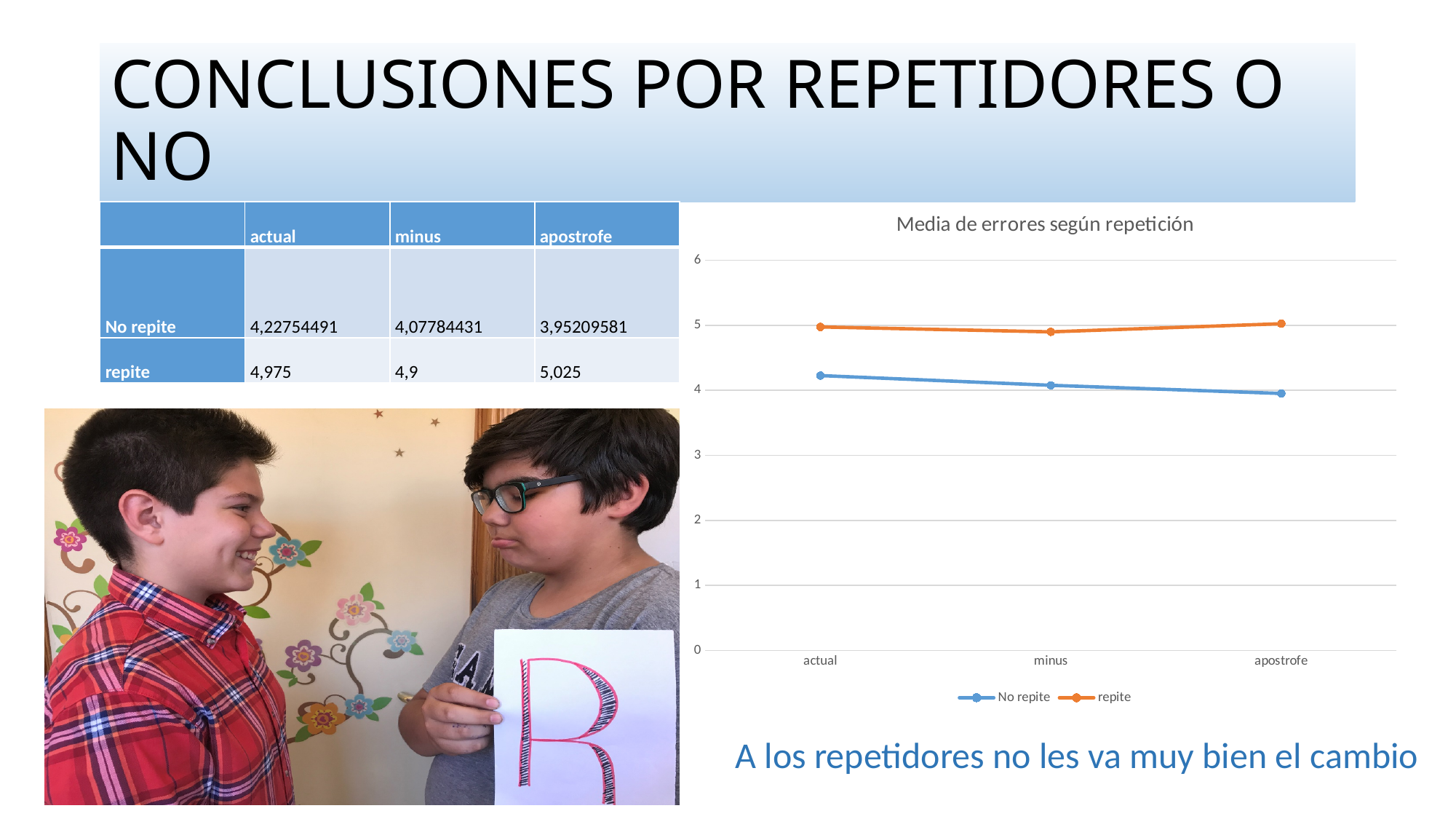
At 'minus', which series has the higher value, 'No repite' or 'repite'? repite Do the values for 'No repite' rise or fall from 'actual' to 'apostrofe'? fall How many series does the legend of the chart list? 2 Is the value for 'repite' at 'actual' greater or less than 4? greater What is the value for 'repite' at 'minus'? 4,9 Which colour is used for the 'repite' series line? orange How many categories are shown along the x axis of the chart? 3 Is the value for 'No repite' at 'actual' greater or less than 5? less What is the title of the chart? Media de errores según repetición What kind of chart is shown on the slide? line chart What is the difference between the 'repite' values at 'apostrofe' and 'actual'? 0,05 What is the value for 'repite' at 'apostrofe'? 5,025